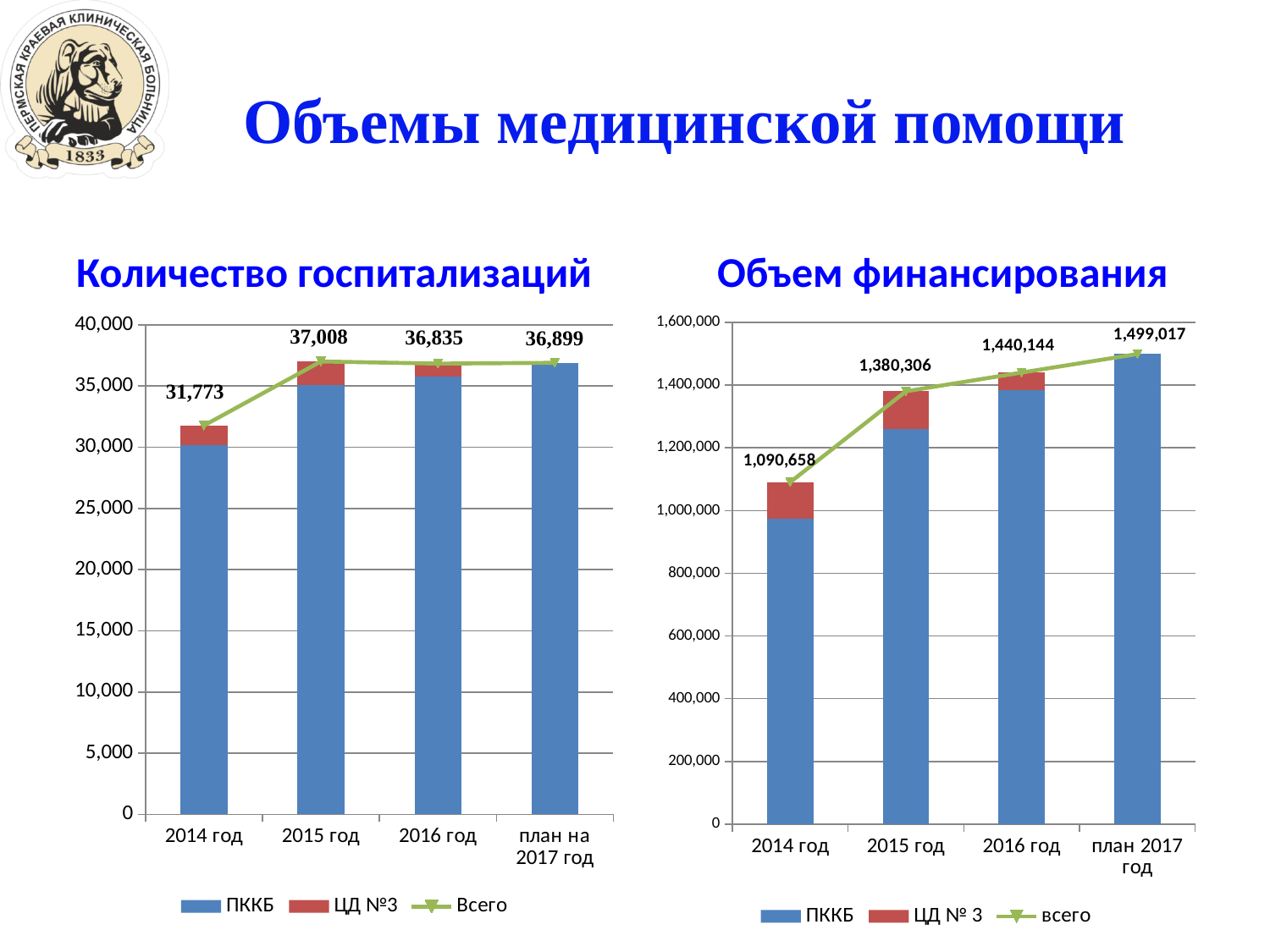
How many series does the legend of the 'Количество госпитализаций' chart list? 3 In the 'Количество госпитализаций' chart, which year has the highest total? 2015 год In the 'Объем финансирования' chart, is the ПККБ value for 2014 год greater or less than 1,000,000? less In the 'Количество госпитализаций' chart, which total is larger: 2016 год or план на 2017 год? план на 2017 год In the 'Количество госпитализаций' chart, what is the total (Всего) value for 2015 год? 37,008 In the 'Количество госпитализаций' chart, what is the difference between the totals for 2015 год and 2014 год? 5,235 In the 'Количество госпитализаций' chart, is the ПККБ value for 2016 год greater or less than 35,000? greater In the 'Объем финансирования' chart, do the total values rise or fall from 2014 год to план 2017 год? rise In the 'Объем финансирования' chart, which category has the lowest total? 2014 год How many categories are shown on the x axis of the 'Объем финансирования' chart? 4 In the 'Объем финансирования' chart, what is the difference between the totals for план 2017 год and 2014 год? 408,359 In the 'Объем финансирования' chart, what is the total (всего) value for 2014 год? 1,090,658